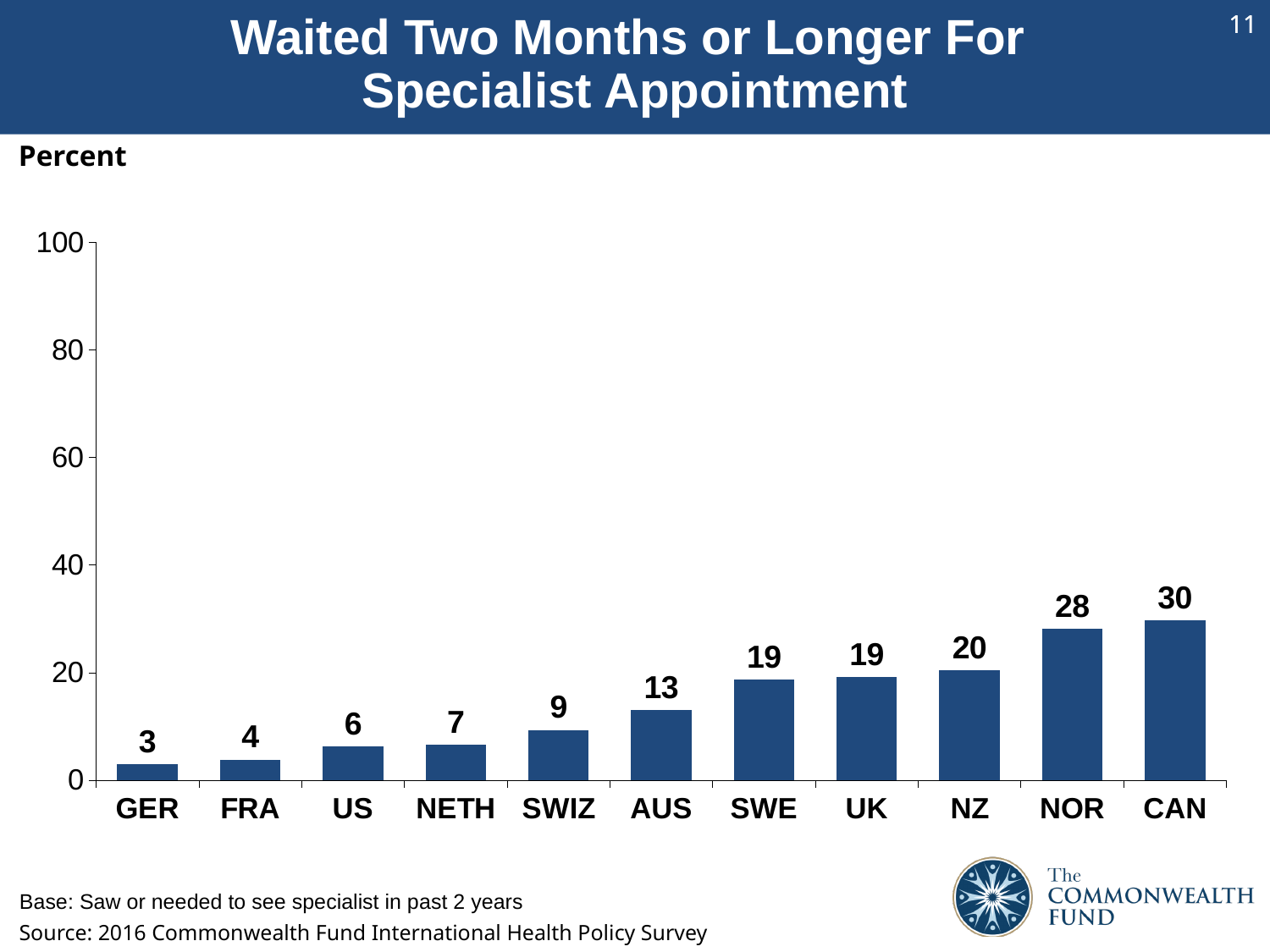
What kind of chart is shown on the slide? bar chart What is the value for SWE? 19 What is the value for CAN? 30 How many countries are shown on the chart? 11 Which is larger, the value for AUS or the value for SWIZ? AUS Is the value for NOR greater or less than 20? greater Which country has the highest value? CAN What is the value for NETH? 7 Do the values rise or fall from left to right along the x axis? rise Which country has the lowest value? GER What is the difference between the values for CAN and GER? 27 What is the difference between the values for NOR and NZ? 8